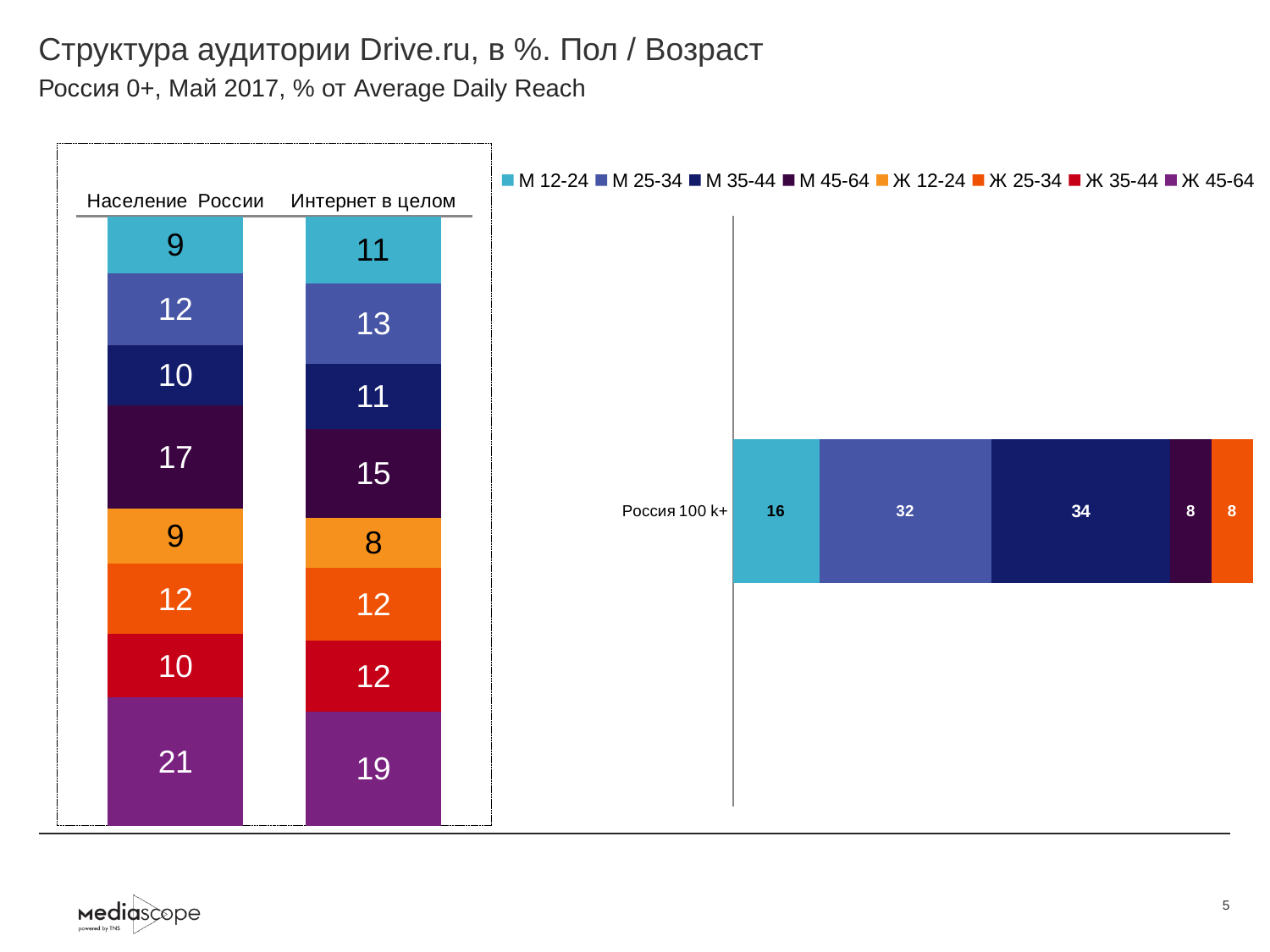
In the left chart, what is the value of the dark purple (М 45-64) segment for Население России? 17 In the left chart, which is larger: the red (Ж 35-44) segment for Население России or for Интернет в целом? Интернет в целом In the right chart (Россия 100 k+), what is the value of the М 35-44 segment? 34 In the right chart (Россия 100 k+), which segment is the largest? М 35-44 What kind of chart is shown on the right side of the slide? Stacked bar chart In the right chart (Россия 100 k+), what is the difference between the М 25-34 and М 12-24 segments? 16 In the left chart, which segment is the largest in the Интернет в целом bar? Ж 45-64 (19) In the left chart, what is the value of the bottom (purple, Ж 45-64) segment for Население России? 21 How many series does the legend on the right list? 8 In the right chart (Россия 100 k+), what is the value of the М 12-24 segment? 16 In the left chart, what is the difference between the Ж 45-64 segments for Население России and Интернет в целом? 2 In the left chart, what is the value of the top (light blue, М 12-24) segment for Интернет в целом? 11